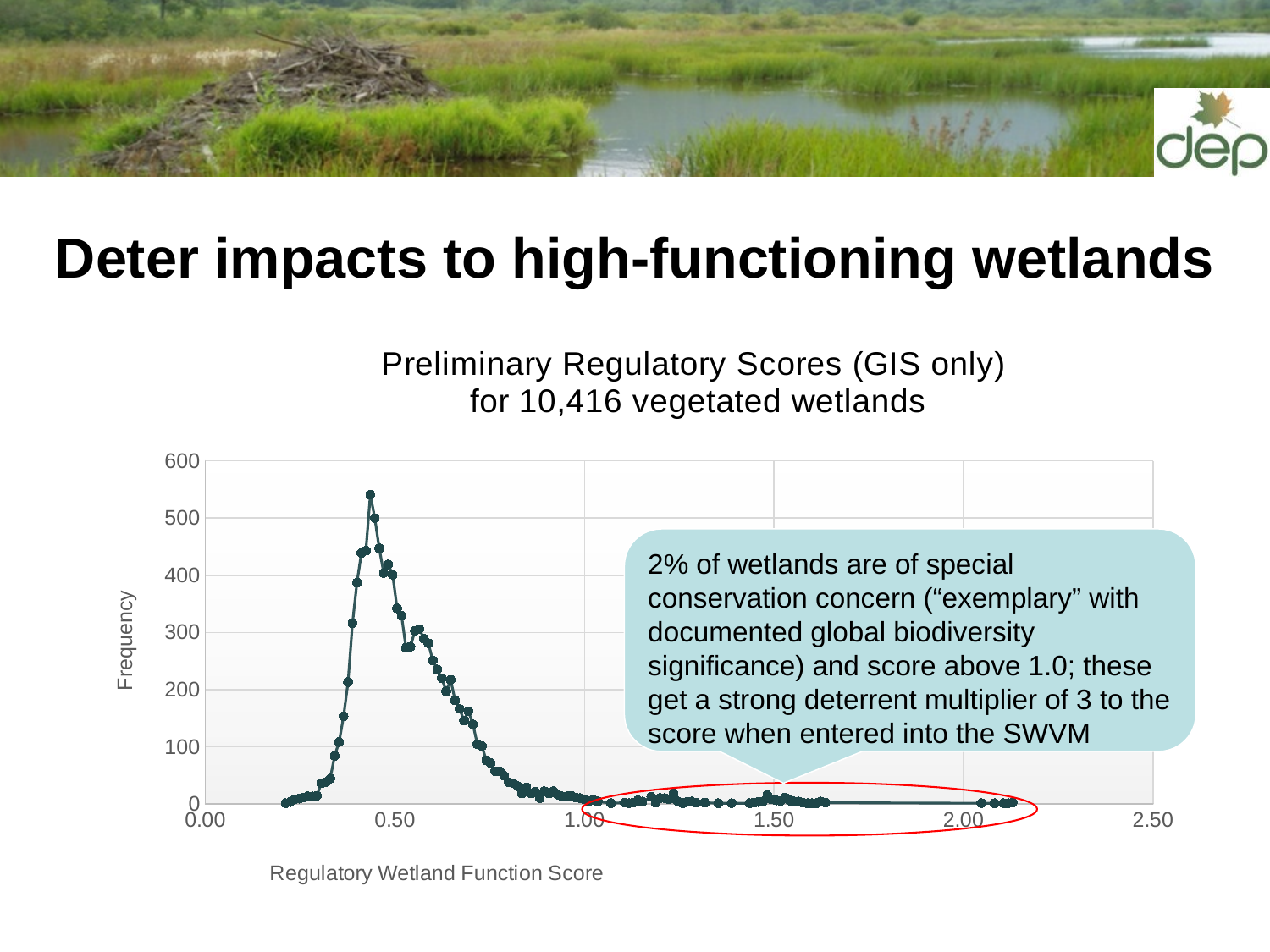
What is the label of the x axis of the chart? Regulatory Wetland Function Score Is the frequency at a Regulatory Wetland Function Score of 1.00 greater or less than 100? less Is the frequency at a score of 0.45 larger or smaller than the frequency at a score of 1.00? larger Is the peak frequency in the chart greater or less than 500? greater How many data series are plotted in the chart? 1 Is the frequency at a Regulatory Wetland Function Score of 0.75 greater or less than 200? less What kind of chart is shown on the slide? line chart Does the frequency rise or fall as the Regulatory Wetland Function Score increases from 0.30 to 0.45? rise What is the title of the chart? Preliminary Regulatory Scores (GIS only) for 10,416 vegetated wetlands Does the frequency rise or fall as the Regulatory Wetland Function Score increases from 0.50 to 1.00? fall